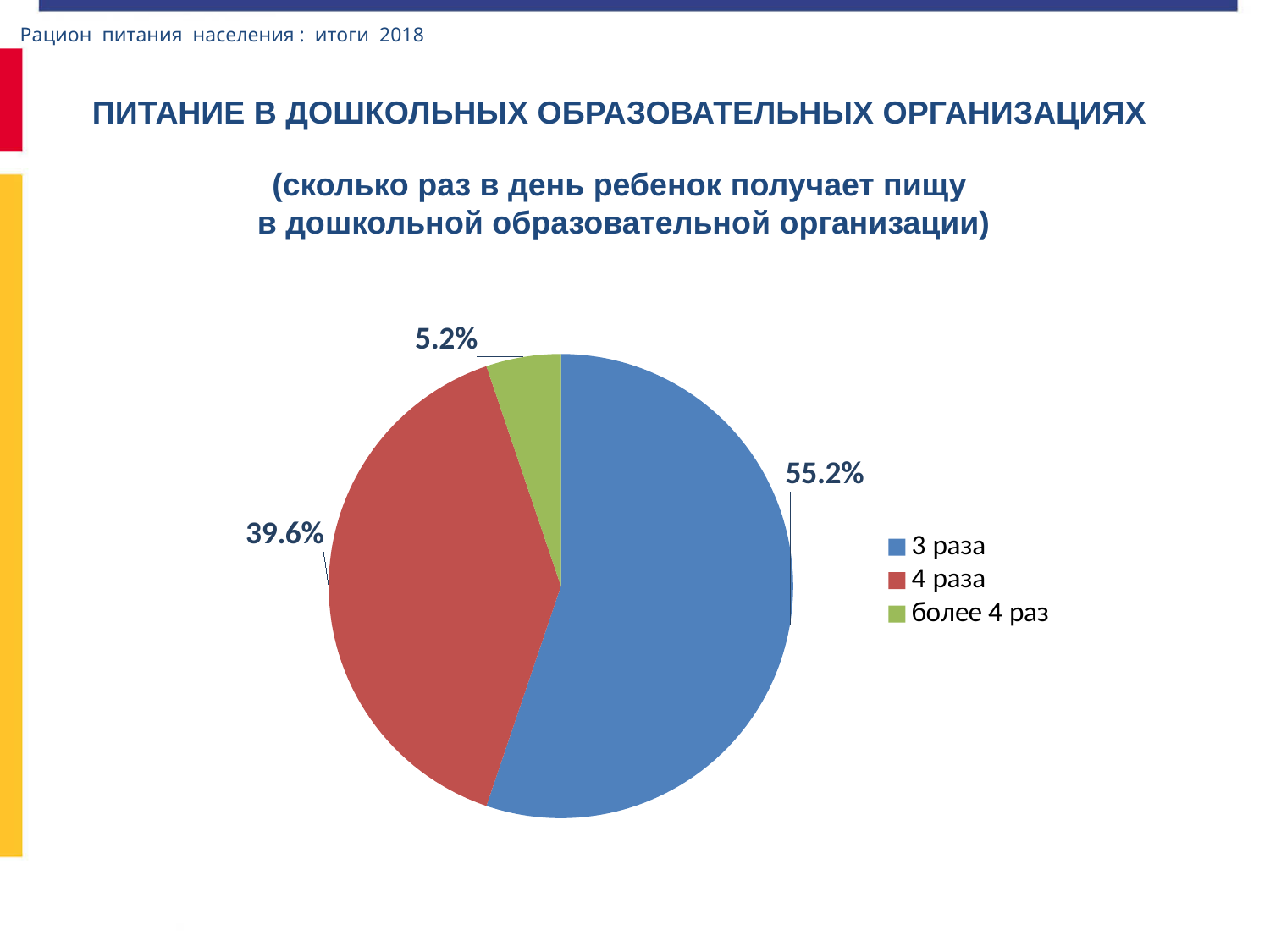
What is the difference between the shares for "4 раза" and "более 4 раз"? 34.4% What is the difference between the shares for "3 раза" and "4 раза"? 15.6% What share of the pie is labelled "3 раза"? 55.2% How many entries does the legend list? 3 What colour is the slice for "более 4 раз"? green What kind of chart is shown on the slide? pie chart Which category has the largest slice of the pie? 3 раза What share of the pie is labelled "4 раза"? 39.6% Which is larger, the share for "4 раза" or the share for "более 4 раз"? 4 раза What share of the pie is labelled "более 4 раз"? 5.2% Which category has the smallest slice of the pie? более 4 раз How many slices does the pie chart have? 3